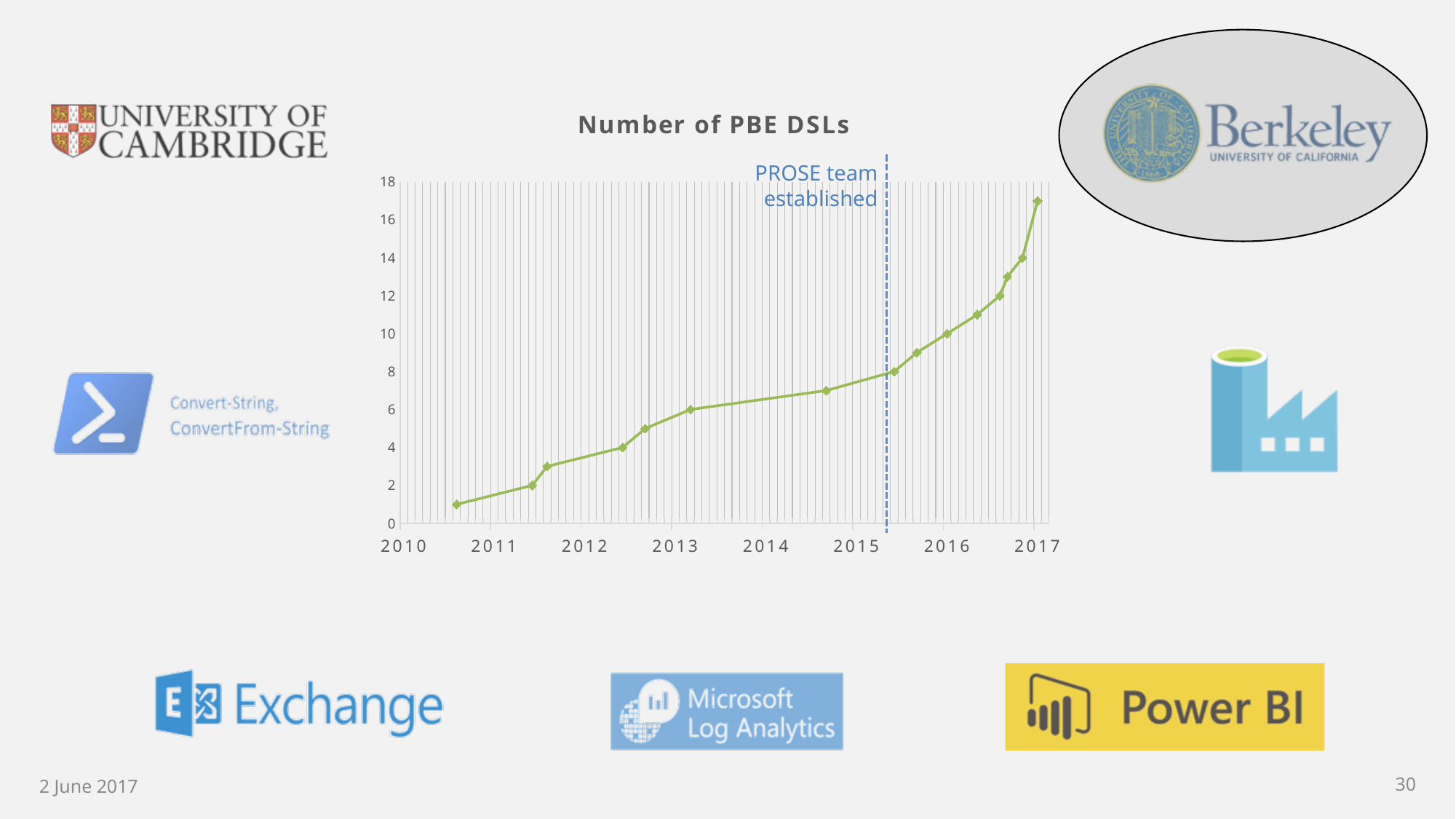
Is the value of the data point at the start of 2016 greater or less than 8? greater How many year labels are shown on the x axis? 8 Is the value of the last data point, at 2017, greater or less than 16? greater Do the values in the chart rise or fall from 2010 to 2017? rise What kind of chart is shown on the slide? line chart Is the value of the first data point, in 2010, greater or less than 2? less Which data point has the highest value, the first one in 2010 or the last one in 2017? the last one in 2017 What is the title of the chart? Number of PBE DSLs What event does the dashed vertical line in the chart mark? PROSE team established What is the highest value shown on the y axis? 18 What is the value of the data point at the start of 2016? 10